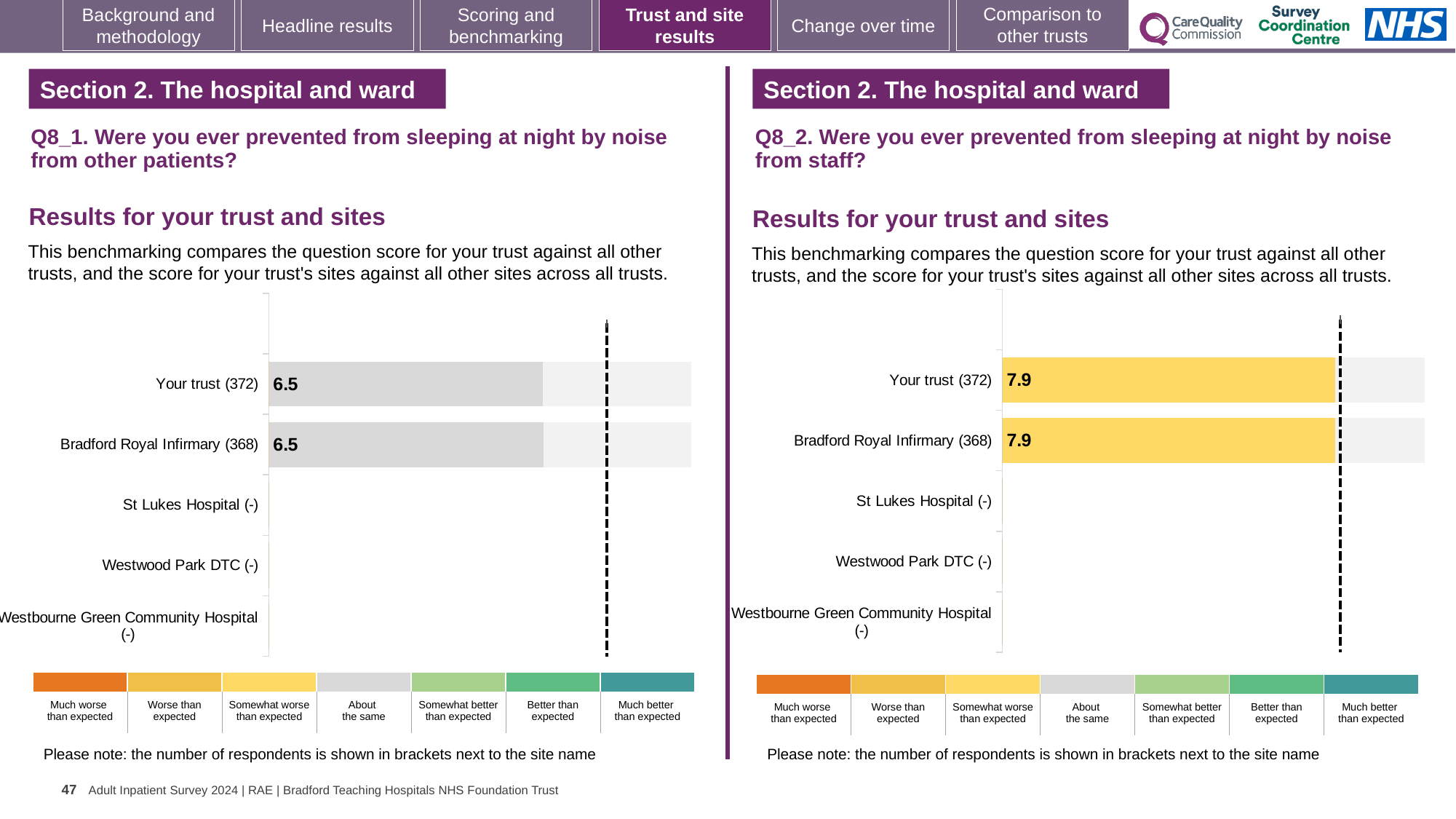
In the Q8_1 chart on the left, what is the difference between the score for Your trust and the score for Bradford Royal Infirmary? 0 In the Q8_2 chart on the right, what is the difference between the score for Your trust and the score for Bradford Royal Infirmary? 0 In the Q8_1 chart on the left, which benchmark category does the colour of the Your trust bar correspond to in the legend? About the same In the Q8_2 chart on the right, what is the score for Your trust (372)? 7.9 What kind of chart is used for the Q8_1 results on the left? Bar chart How many site/trust categories are listed on the y axis of the Q8_1 chart on the left? 5 How many site/trust categories are listed on the y axis of the Q8_2 chart on the right? 5 In the Q8_2 chart on the right, which benchmark category does the colour of the Your trust bar correspond to in the legend? Somewhat worse than expected In the Q8_1 chart on the left, how many categories have no score shown (marked with a dash)? 3 In the Q8_2 chart on the right, what is the score for Bradford Royal Infirmary (368)? 7.9 In the Q8_1 chart on the left, what is the score for Your trust (372)? 6.5 In the Q8_1 chart on the left, what is the score for Bradford Royal Infirmary (368)? 6.5